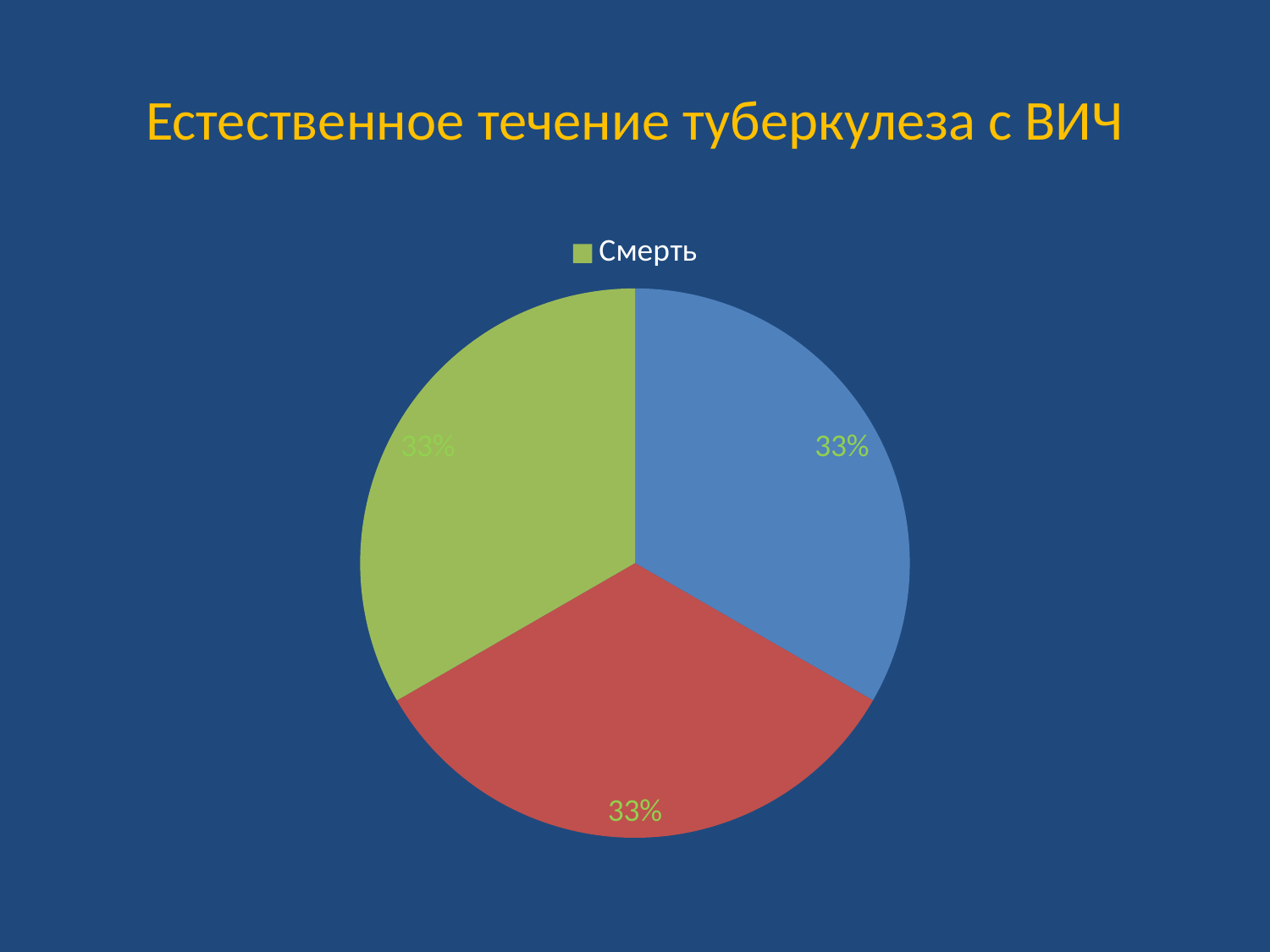
Which colour represents "Смерть" in the pie chart legend? green What is the value shown on the red slice of the pie chart? 33% What share of the pie does the "Смерть" slice represent? 33% What is the value shown on the blue slice of the pie chart? 33% What is the value shown on the green slice of the pie chart? 33% What kind of chart is shown on the slide? pie chart How many slices does the pie chart have? 3 What is the title of the slide containing the pie chart? Естественное течение туберкулеза с ВИЧ How many entries does the legend of the pie chart list? 1